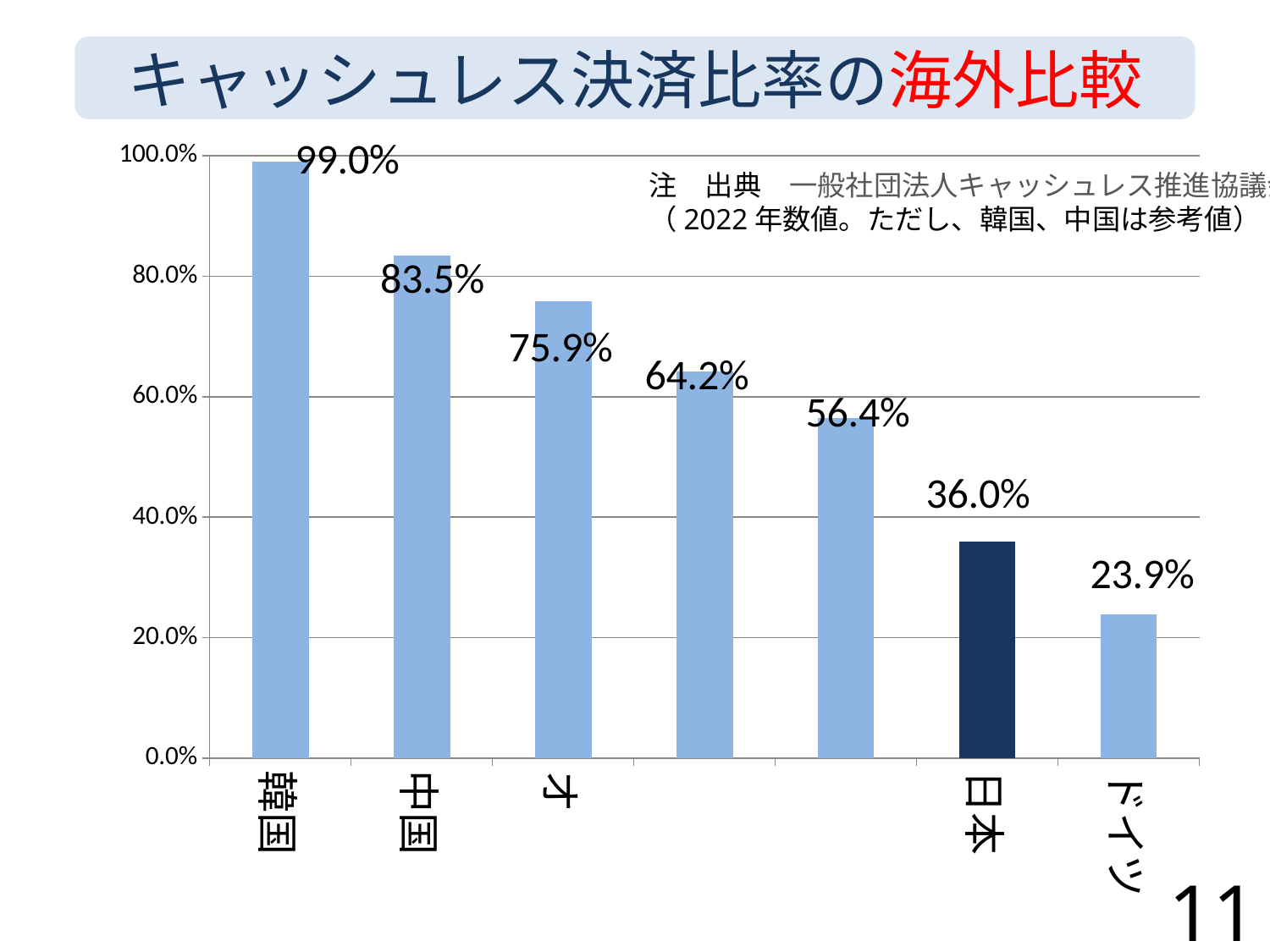
What is the difference between the cashless payment ratios of 日本 and ドイツ? 12.1% How many bars are plotted in the chart? 7 Which has a higher cashless payment ratio, 中国 or 日本? 中国 What is the cashless payment ratio shown for 日本? 36.0% What is the cashless payment ratio shown for ドイツ? 23.9% Which country has the lowest cashless payment ratio in the chart? ドイツ What type of chart is shown on the slide? bar chart What is the cashless payment ratio shown for 韓国? 99.0% What is the cashless payment ratio shown for 中国? 83.5% Do the bar values rise or fall from left to right along the x axis? fall What is the difference between the cashless payment ratios of 韓国 and 日本? 63.0% Which country has the highest cashless payment ratio in the chart? 韓国